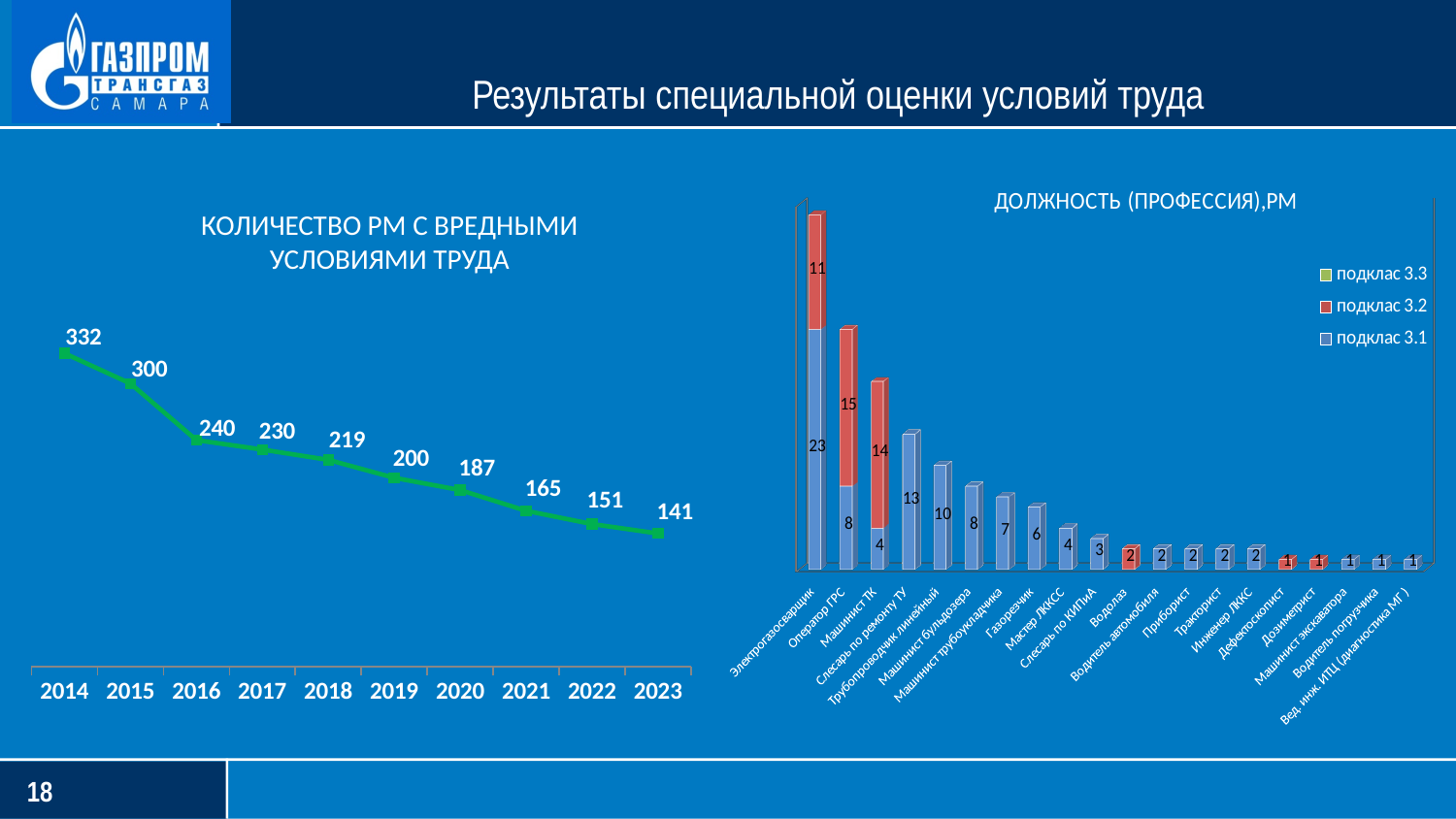
On the line chart 'КОЛИЧЕСТВО РМ С ВРЕДНЫМИ УСЛОВИЯМИ ТРУДА', how many years are plotted? 10 What kind of chart is the chart on the left of the slide? line chart On the line chart 'КОЛИЧЕСТВО РМ С ВРЕДНЫМИ УСЛОВИЯМИ ТРУДА', what is the value for 2014? 332 On the bar chart 'ДОЛЖНОСТЬ (ПРОФЕССИЯ),РМ', how many series does the legend list? 3 On the line chart 'КОЛИЧЕСТВО РМ С ВРЕДНЫМИ УСЛОВИЯМИ ТРУДА', what is the difference between the values for 2014 and 2023? 191 On the bar chart 'ДОЛЖНОСТЬ (ПРОФЕССИЯ),РМ', which profession has the tallest bar? Электрогазосварщик On the line chart 'КОЛИЧЕСТВО РМ С ВРЕДНЫМИ УСЛОВИЯМИ ТРУДА', what is the value for 2020? 187 On the bar chart 'ДОЛЖНОСТЬ (ПРОФЕССИЯ),РМ', what is the value of подклас 3.2 for Оператор ГРС? 15 On the line chart 'КОЛИЧЕСТВО РМ С ВРЕДНЫМИ УСЛОВИЯМИ ТРУДА', which year has the lowest value? 2023 On the bar chart 'ДОЛЖНОСТЬ (ПРОФЕССИЯ),РМ', which is larger: the value for Слесарь по ремонту ТУ or the value for Газорезчик? Слесарь по ремонту ТУ On the bar chart 'ДОЛЖНОСТЬ (ПРОФЕССИЯ),РМ', what is the total of the stacked bar for Электрогазосварщик? 34 On the line chart 'КОЛИЧЕСТВО РМ С ВРЕДНЫМИ УСЛОВИЯМИ ТРУДА', do the values rise or fall from 2014 to 2023? fall